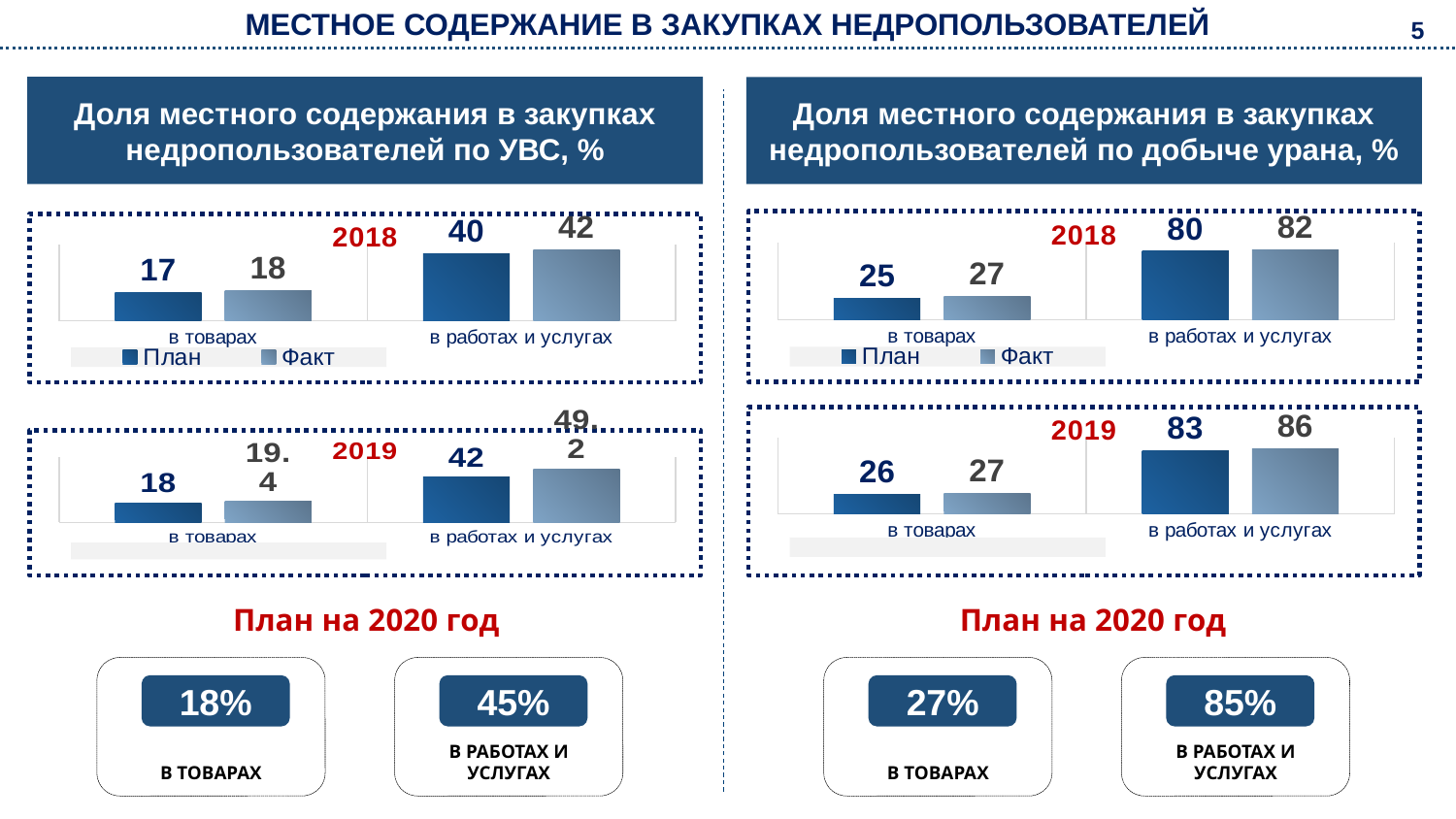
In the 2018 chart under 'Доля местного содержания в закупках недропользователей по добыче урана, %', what is the План value for 'в работах и услугах'? 80 In the 2018 chart under 'Доля местного содержания в закупках недропользователей по УВС, %', which category has the highest Факт value? в работах и услугах In the 2018 chart under 'Доля местного содержания в закупках недропользователей по УВС, %', what is the План value for 'в товарах'? 17 In the 2019 chart under 'Доля местного содержания в закупках недропользователей по добыче урана, %', what is the Факт value for 'в работах и услугах'? 86 In the 2019 chart under 'Доля местного содержания в закупках недропользователей по УВС, %', what is the difference between the Факт and План values for 'в работах и услугах'? 7.2 In the 2018 chart under 'Доля местного содержания в закупках недропользователей по УВС, %', what is the Факт value for 'в работах и услугах'? 42 In the 2019 chart under 'Доля местного содержания в закупках недропользователей по УВС, %', what is the Факт value for 'в работах и услугах'? 49.2 In the 2018 chart under 'Доля местного содержания в закупках недропользователей по добыче урана, %', what is the difference between the Факт and План values for 'в товарах'? 2 How many categories are shown on the x axis of the 2018 chart under 'Доля местного содержания в закупках недропользователей по добыче урана, %'? 2 How many series does the legend list in the 2018 chart under 'Доля местного содержания в закупках недропользователей по УВС, %'? 2 What kind of chart is the 2019 chart under 'Доля местного содержания в закупках недропользователей по добыче урана, %'? Bar chart In the 2019 chart under 'Доля местного содержания в закупках недропользователей по добыче урана, %', which is larger for 'в товарах': План or Факт? Факт